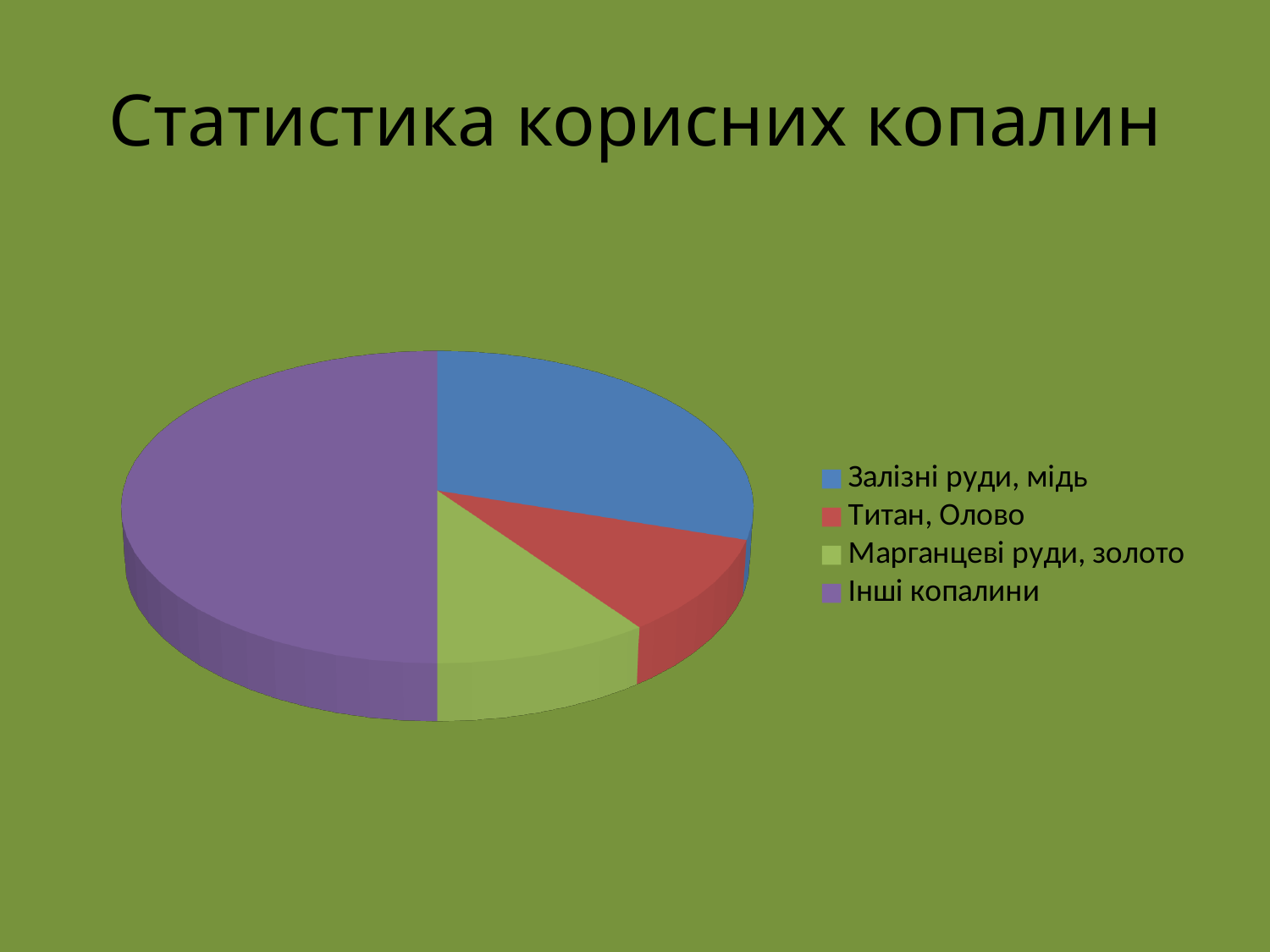
Which category has the largest slice of the pie? Інші копалини What is the title of the slide? Статистика корисних копалин What colour is the slice for Титан, Олово? red How many entries does the legend list? 4 What kind of chart is shown on the slide? pie chart Which slice is larger: Залізні руди, мідь or Марганцеві руди, золото? Залізні руди, мідь How many categories does the pie chart show? 4 Which slice is larger: Залізні руди, мідь or Титан, Олово? Залізні руди, мідь Which slice is larger: Інші копалини or Залізні руди, мідь? Інші копалини